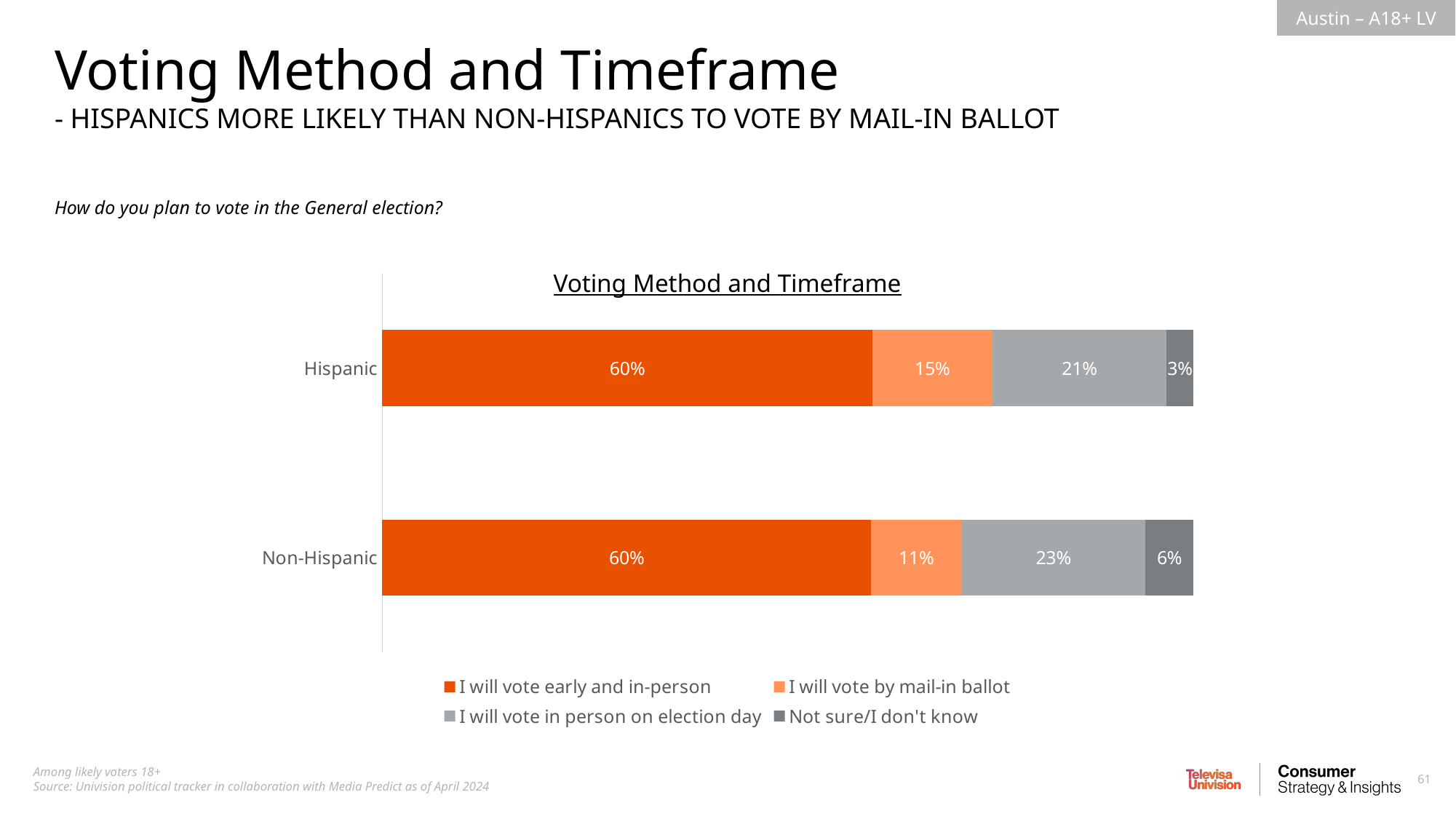
How many series does the legend list? 4 Which group has the higher share saying they will vote by mail-in ballot, Hispanic or Non-Hispanic? Hispanic What is the difference between the Non-Hispanic and Hispanic shares for 'Not sure/I don't know'? 3 percentage points What percentage of Hispanic respondents say they will vote by mail-in ballot? 15% What percentage of Non-Hispanic respondents are not sure or don't know how they will vote? 6% What kind of chart is shown on the slide? Stacked bar chart What percentage of Non-Hispanic respondents say they will vote in person on election day? 23% What percentage of Hispanic respondents say they will vote early and in-person? 60% How many groups (categories) are shown on the chart? 2 Which voting method has the highest share among Hispanic respondents? I will vote early and in-person What is the difference between the Hispanic and Non-Hispanic shares for voting by mail-in ballot? 4 percentage points Which response has the lowest share among Non-Hispanic respondents? Not sure/I don't know